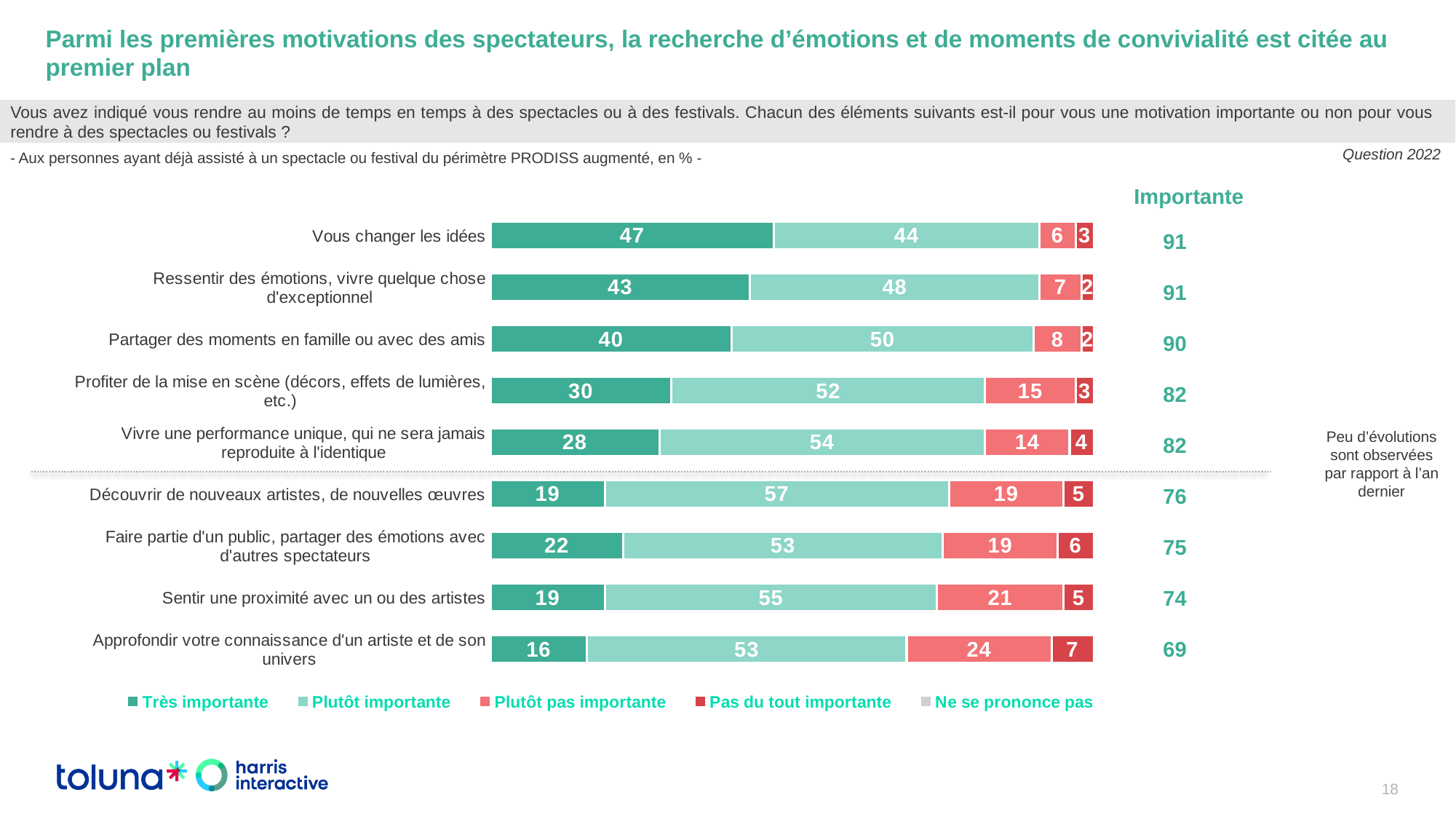
What is the value for "Très importante" for "Vous changer les idées"? 47 Which category has the lowest "Très importante" value? Approfondir votre connaissance d'un artiste et de son univers What is the value for "Plutôt pas importante" for "Approfondir votre connaissance d'un artiste et de son univers"? 24 What kind of chart is shown on the slide? Stacked bar chart What is the "Importante" value shown for "Sentir une proximité avec un ou des artistes"? 74 Which category has the highest "Plutôt pas importante" value? Approfondir votre connaissance d'un artiste et de son univers How many categories (motivations) are shown in the chart? 9 How many series does the legend list? 5 What is the combined total of "Très importante" and "Plutôt importante" for "Profiter de la mise en scène (décors, effets de lumières, etc.)"? 82 Which category has the highest "Très importante" value? Vous changer les idées What is the difference between the "Plutôt importante" values for "Découvrir de nouveaux artistes, de nouvelles œuvres" and "Vous changer les idées"? 13 Which has the larger "Pas du tout importante" value: "Approfondir votre connaissance d'un artiste et de son univers" or "Faire partie d'un public, partager des émotions avec d'autres spectateurs"? Approfondir votre connaissance d'un artiste et de son univers